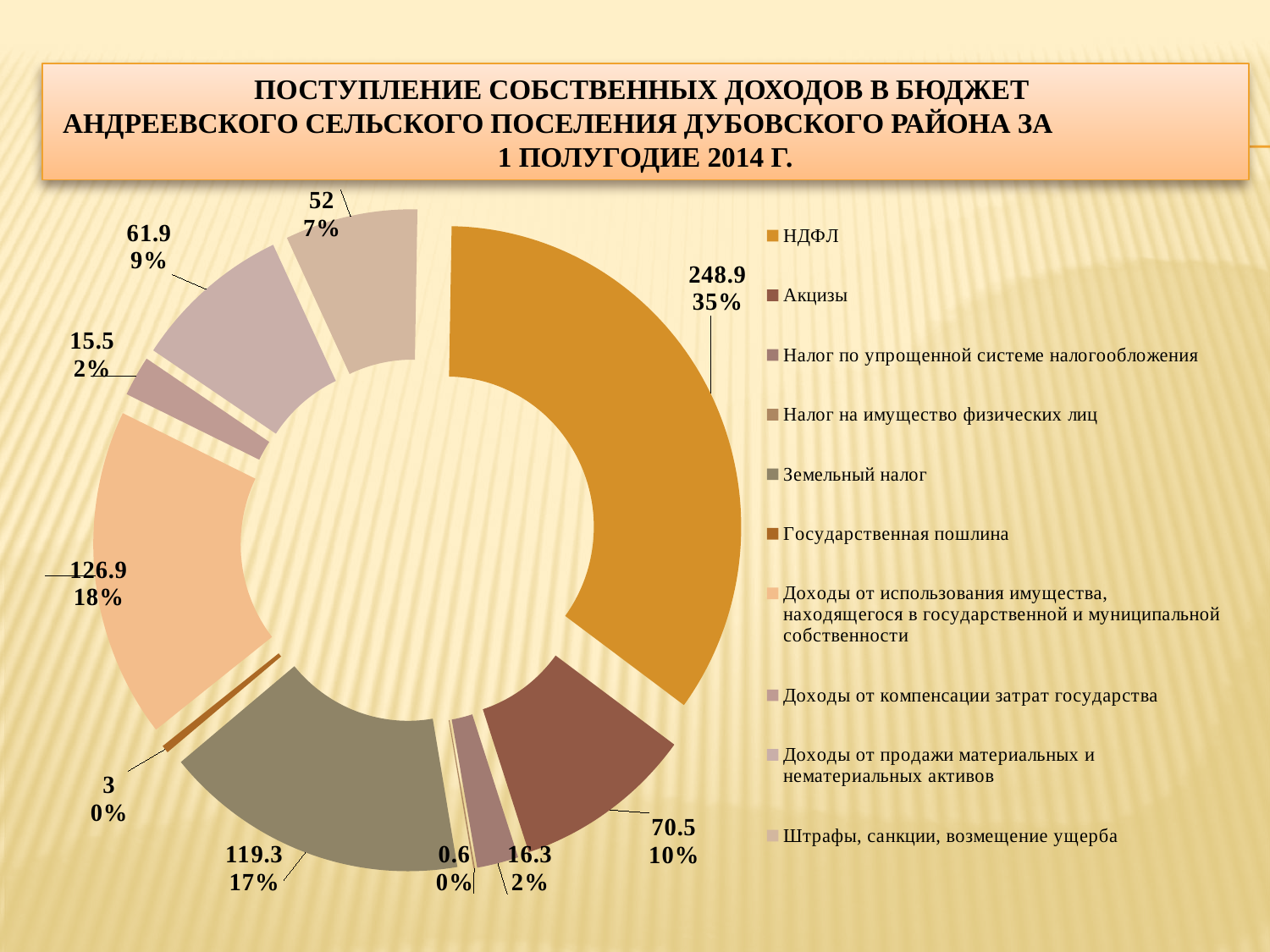
What kind of chart is shown on the slide? doughnut (pie) chart What share of the total does Доходы от использования имущества, находящегося в государственной и муниципальной собственности account for? 18% How many entries does the legend list? 10 What is the difference between the values for НДФЛ and Акцизы? 178.4 What is the value shown for НДФЛ? 248.9 Which is larger, the value for Земельный налог or the value for Доходы от продажи материальных и нематериальных активов? Земельный налог What is the value shown for Земельный налог? 119.3 What share of the total does НДФЛ account for? 35% What share of the total does Акцизы account for? 10% Which category has the largest value? НДФЛ Which category has the smallest value? Налог на имущество физических лиц What is the value shown for Штрафы, санкции, возмещение ущерба? 52